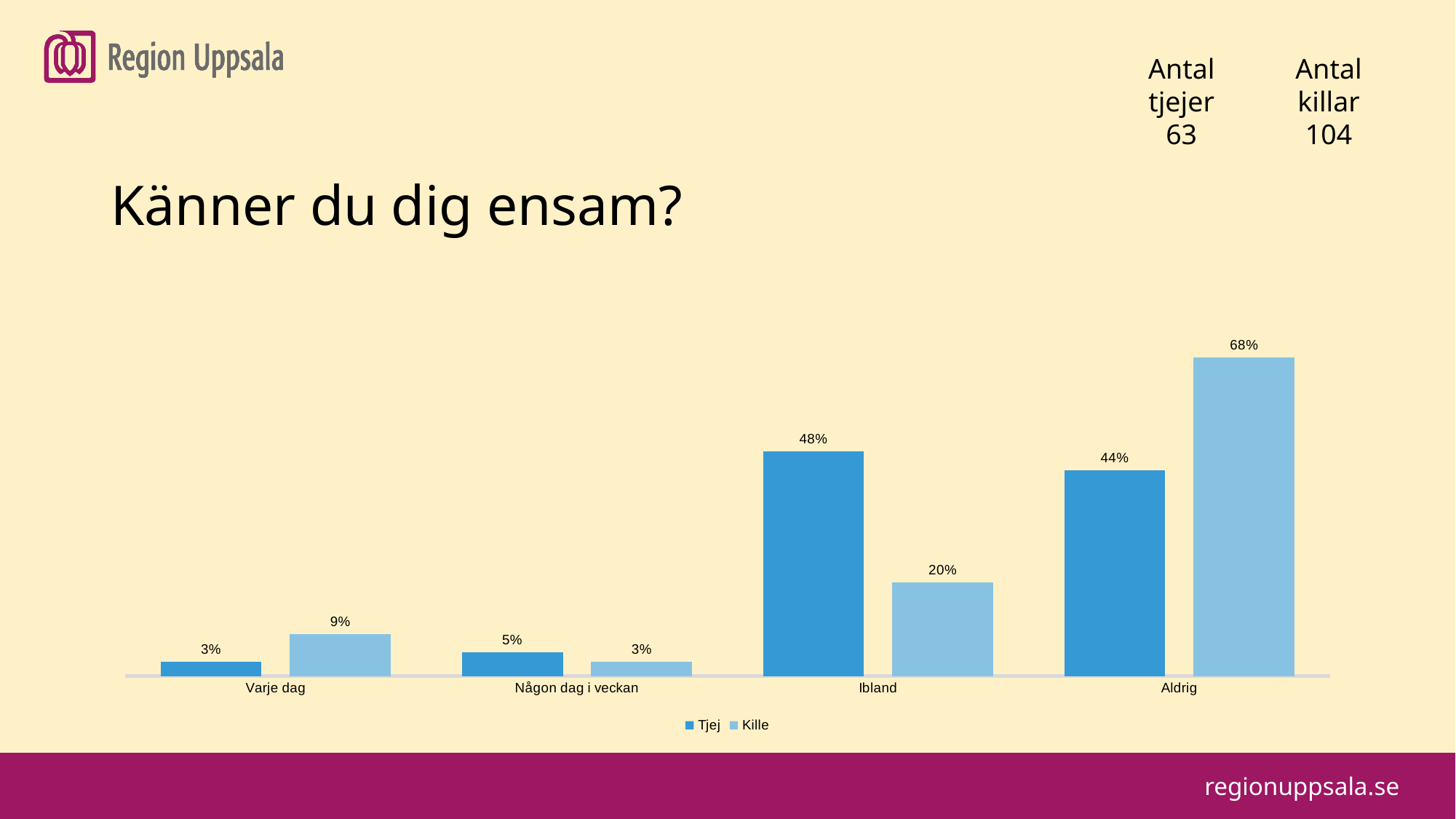
How many series does the legend list? 2 What is the difference between the Kille and Tjej values in the Aldrig category? 24% What is the value for Tjej in the Ibland category? 48% Which is larger in the Varje dag category, Tjej or Kille? Kille What is the value for Kille in the Varje dag category? 9% Which category has the lowest value for Tjej? Varje dag What kind of chart is shown on the slide? Bar chart What is the difference between the Tjej and Kille values in the Ibland category? 28% What is the value for Kille in the Aldrig category? 68% How many categories are shown on the x axis? 4 Which category has the highest value for Kille? Aldrig What is the value for Tjej in the Någon dag i veckan category? 5%